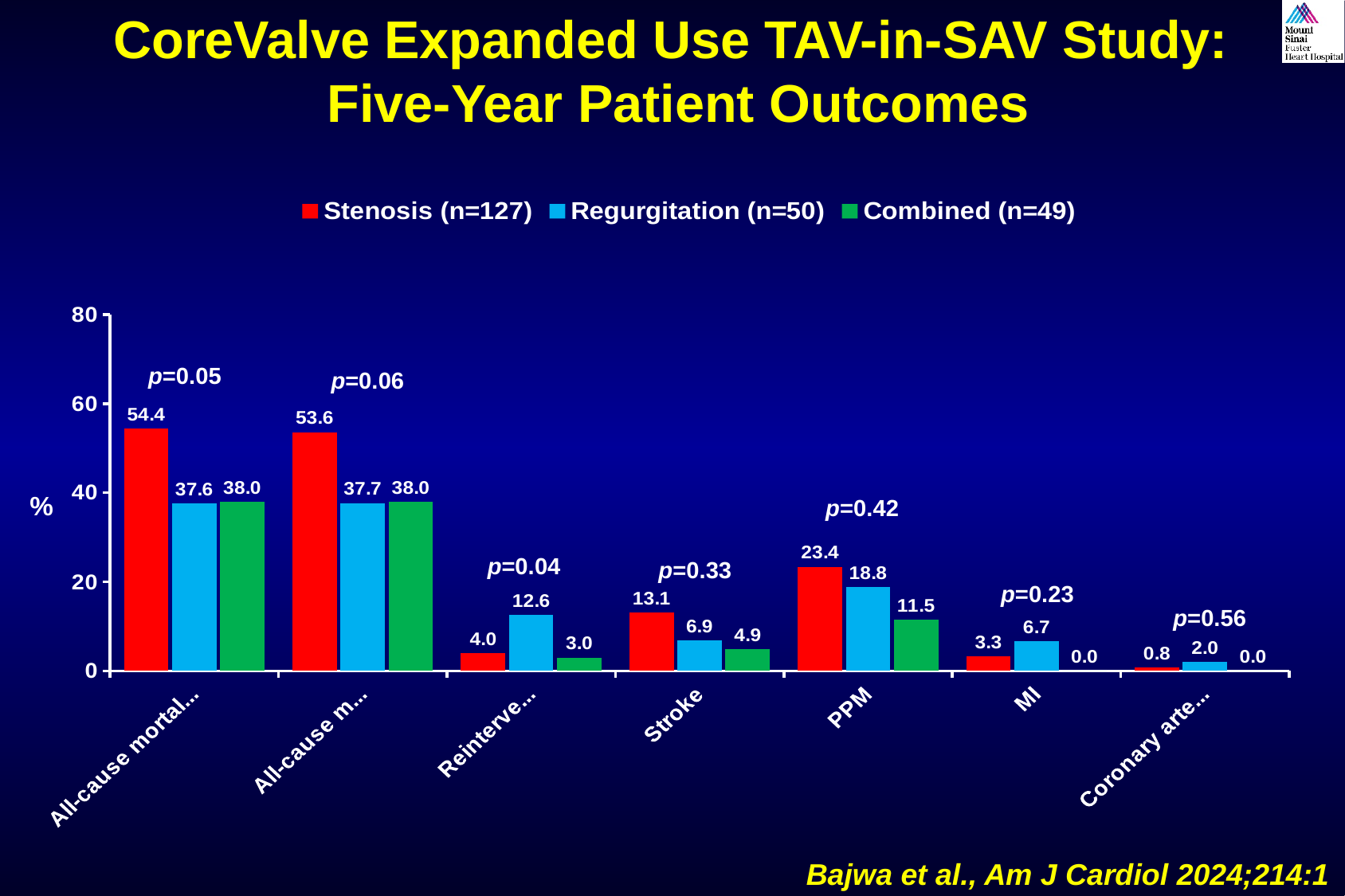
In the MI category, what is the difference between the Regurgitation (n=50) and Stenosis (n=127) values? 3.4 How many categories are shown on the x axis of the chart? 7 What is the value for Combined (n=49) in the MI category? 0.0 In the Stroke category, which is larger: the Stenosis (n=127) value or the Regurgitation (n=50) value? Stenosis (n=127) What is the value for Regurgitation (n=50) in the PPM category? 18.8 Is the value for Stenosis (n=127) in the PPM category greater or less than 20? greater What kind of chart is shown on the slide? bar chart Which series has the lowest value in the Stroke category? Combined (n=49) What is the value for Stenosis (n=127) in the Stroke category? 13.1 In the PPM category, what is the difference between the Stenosis (n=127) and Regurgitation (n=50) values? 4.6 Which series has the highest value in the PPM category? Stenosis (n=127) How many series does the legend list? 3